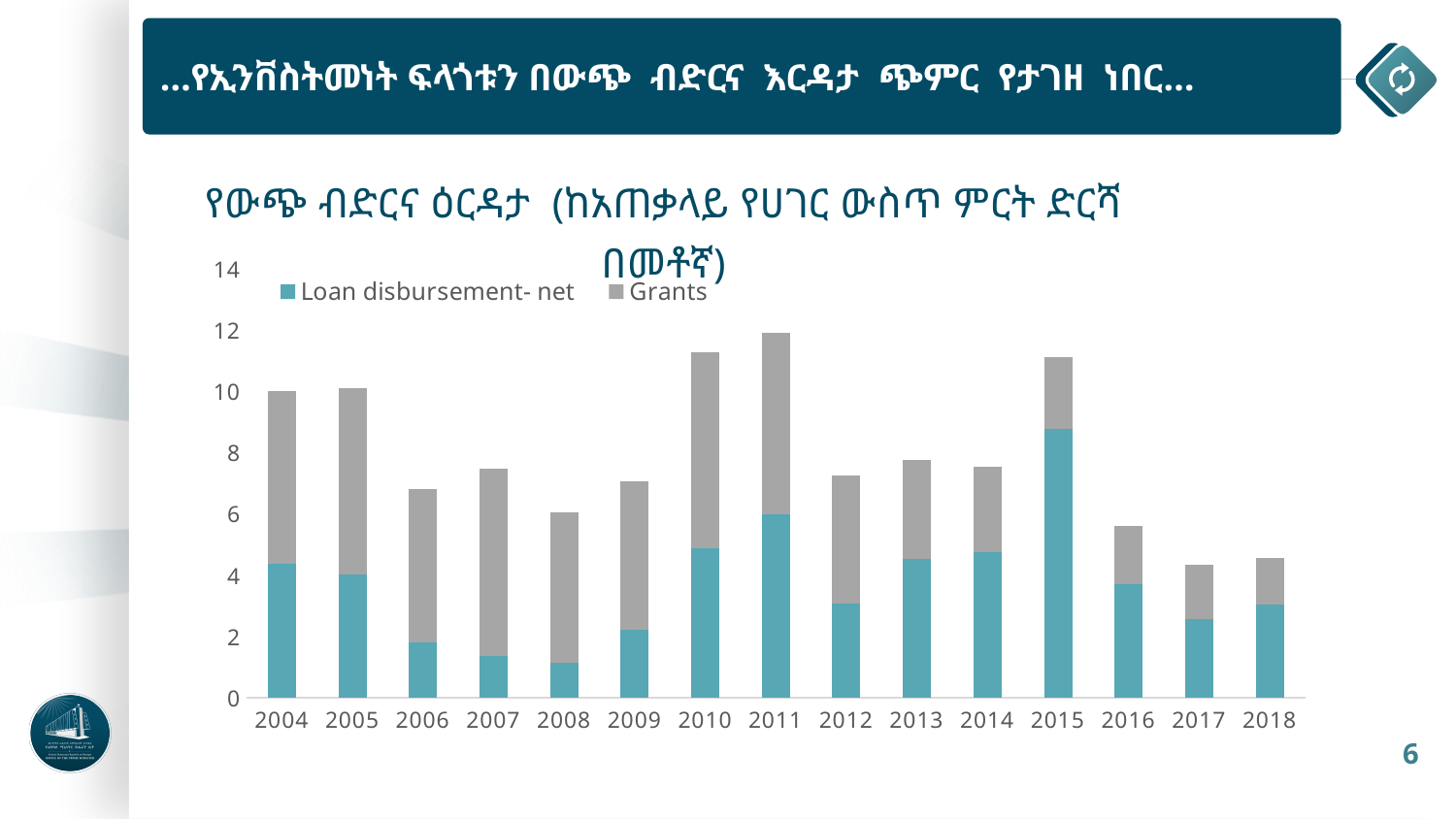
Which year has the highest total bar in the chart? 2011 What kind of chart is shown on the slide? stacked bar chart How many years are shown on the x axis of the chart? 15 What are the two series named in the chart's legend? Loan disbursement- net and Grants Do the total bars rise or fall from 2015 to 2018? fall Is the Loan disbursement- net value for 2015 greater or less than 8? greater Is the total bar for 2008 greater or less than 8? less Which year has the larger total bar, 2010 or 2012? 2010 Which year has the highest Loan disbursement- net value? 2015 Which series is shown in gray in the chart? Grants How many series does the chart's legend list? 2 Is the total bar for 2004 greater or less than 8? greater